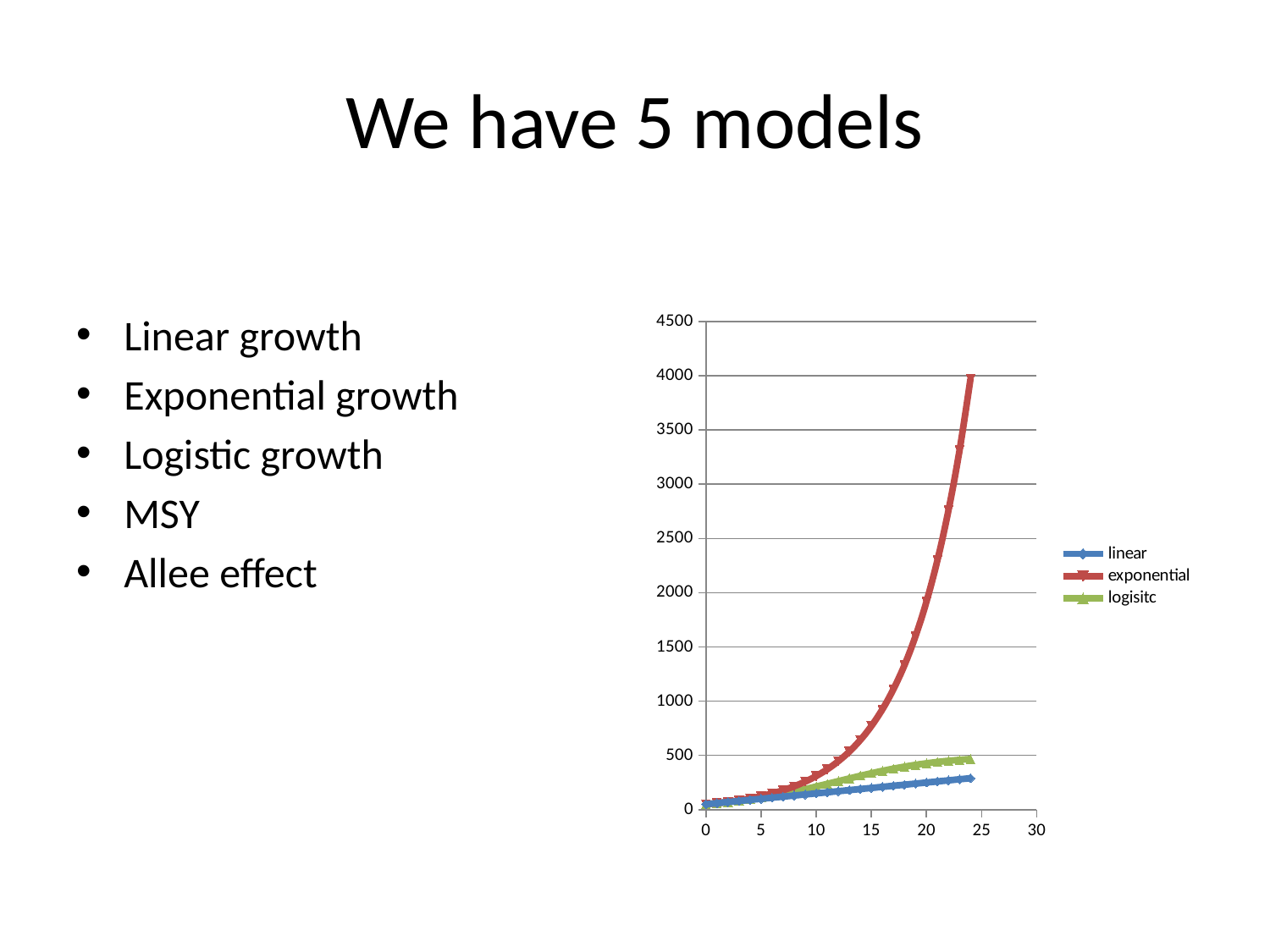
What is the highest value shown on the chart's vertical axis? 4500 What kind of chart is shown on the slide? line chart Is the value of the exponential series at x = 24 greater or less than 3500? greater Do the values of the exponential series rise or fall as x increases? rise Is the value of the linear series at x = 24 greater or less than 500? less Which series has the lowest value at x = 24? linear Is the value of the exponential series at x = 20 greater or less than 2500? less How many series does the chart's legend list? 3 Which series has the highest value at x = 24? exponential Which colour is used for the exponential series in the chart? red What are the three series named in the chart's legend? linear, exponential, logisitc At x = 20, which series has the larger value, exponential or logisitc? exponential